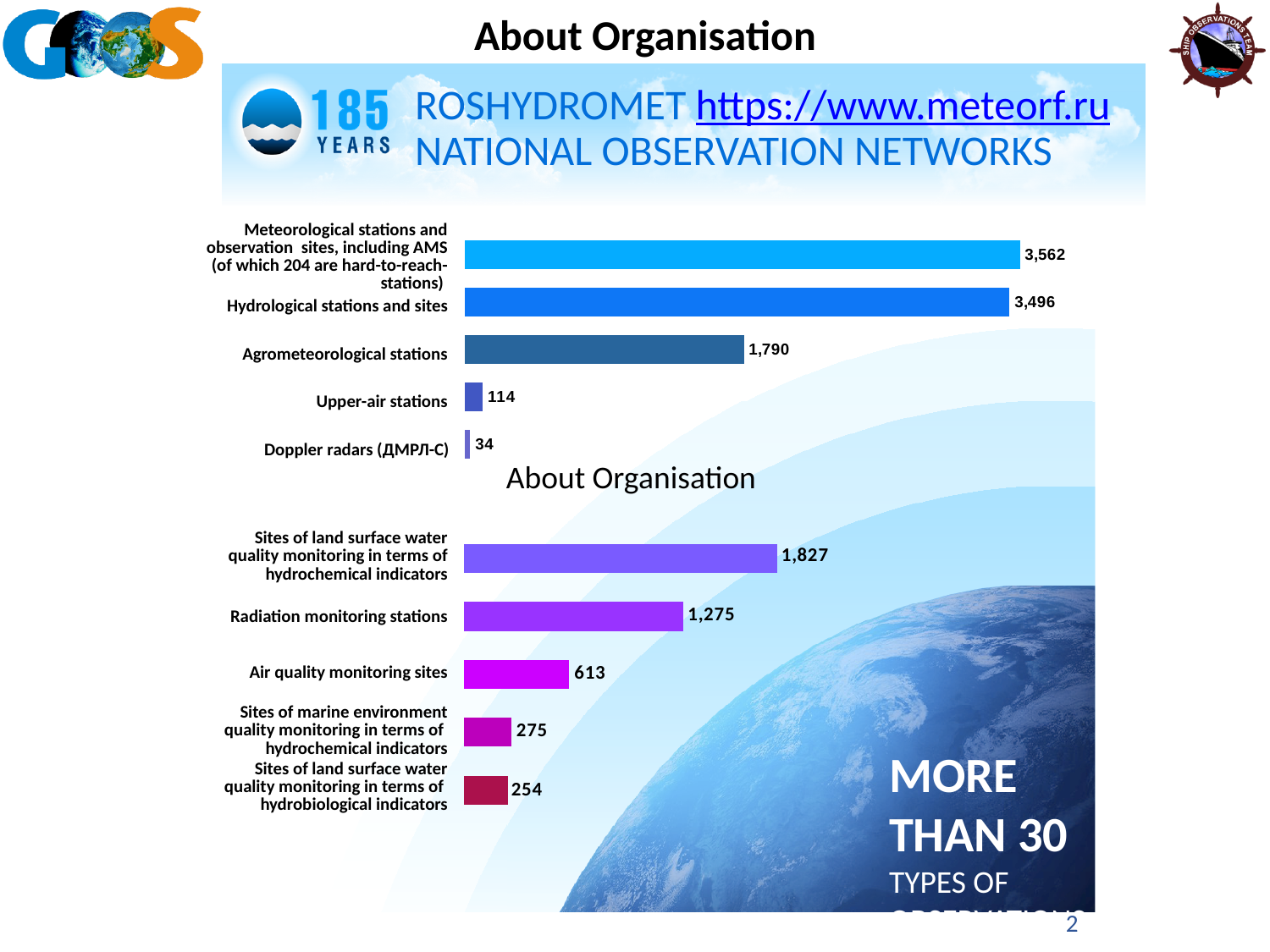
In the upper chart, which category has the lowest value? Doppler radars (ДМРЛ-С) In the lower chart, what is the value for Radiation monitoring stations? 1,275 In the upper chart, what is the value for Doppler radars (ДМРЛ-С)? 34 In the upper chart, what is the difference between the values for Agrometeorological stations and Upper-air stations? 1,676 In the lower chart, which category has the highest value? Sites of land surface water quality monitoring in terms of hydrochemical indicators In the upper chart, what is the value for Hydrological stations and sites? 3,496 In the lower chart, what is the difference between the values for Radiation monitoring stations and Air quality monitoring sites? 662 In the upper chart, how many categories are plotted? 5 In the lower chart, which is larger: the value for Air quality monitoring sites or the value for Sites of marine environment quality monitoring in terms of hydrochemical indicators? Air quality monitoring sites In the lower chart, what is the value for Air quality monitoring sites? 613 In the upper chart, what is the value for Agrometeorological stations? 1,790 What kind of chart is the lower chart? Bar chart